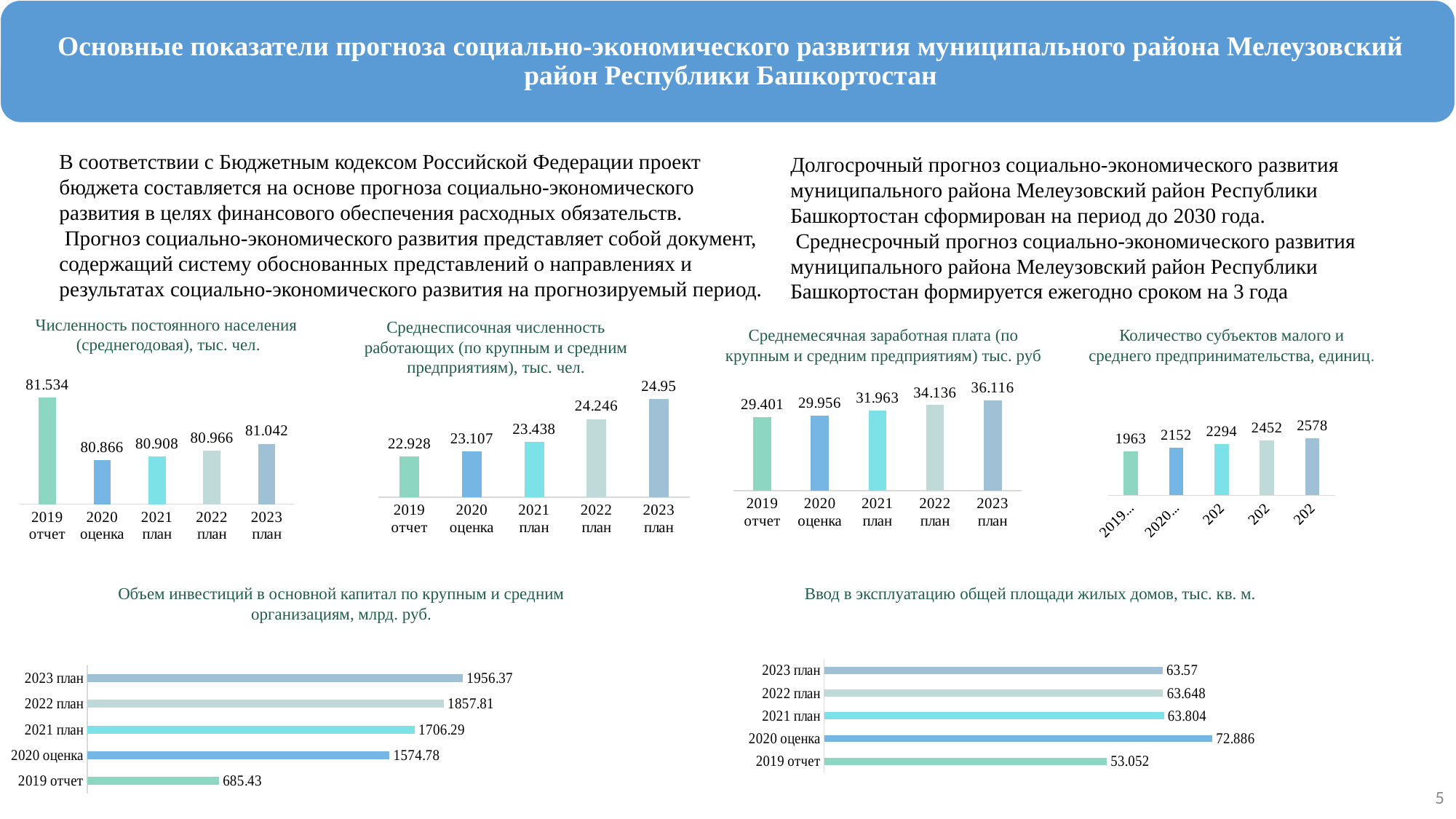
In the chart 'Численность постоянного населения (среднегодовая), тыс. чел.', which category has the highest value? 2019 отчет In the chart 'Среднесписочная численность работающих (по крупным и средним предприятиям), тыс. чел.', what is the value for 2023 план? 24.95 In the chart 'Ввод в эксплуатацию общей площади жилых домов, тыс. кв. м.', which is larger: the value for 2019 отчет or 2023 план? 2023 план In the chart 'Среднемесячная заработная плата (по крупным и средним предприятиям) тыс. руб', what is the value for 2021 план? 31.963 In the chart 'Среднемесячная заработная плата (по крупным и средним предприятиям) тыс. руб', what is the difference between the 2023 план and 2019 отчет values? 6.715 How many bars are in the chart 'Количество субъектов малого и среднего предпринимательства, единиц.'? 5 In the chart 'Ввод в эксплуатацию общей площади жилых домов, тыс. кв. м.', which category has the highest value? 2020 оценка In the chart 'Количество субъектов малого и среднего предпринимательства, единиц.', what is the highest value shown? 2578 What type of chart is 'Объем инвестиций в основной капитал по крупным и средним организациям, млрд. руб.'? bar chart In the chart 'Среднесписочная численность работающих (по крупным и средним предприятиям), тыс. чел.', do the values rise or fall from 2019 отчет to 2023 план? rise In the chart 'Объем инвестиций в основной капитал по крупным и средним организациям, млрд. руб.', what is the value for 2019 отчет? 685.43 In the chart 'Численность постоянного населения (среднегодовая), тыс. чел.', what is the value for 2020 оценка? 80.866